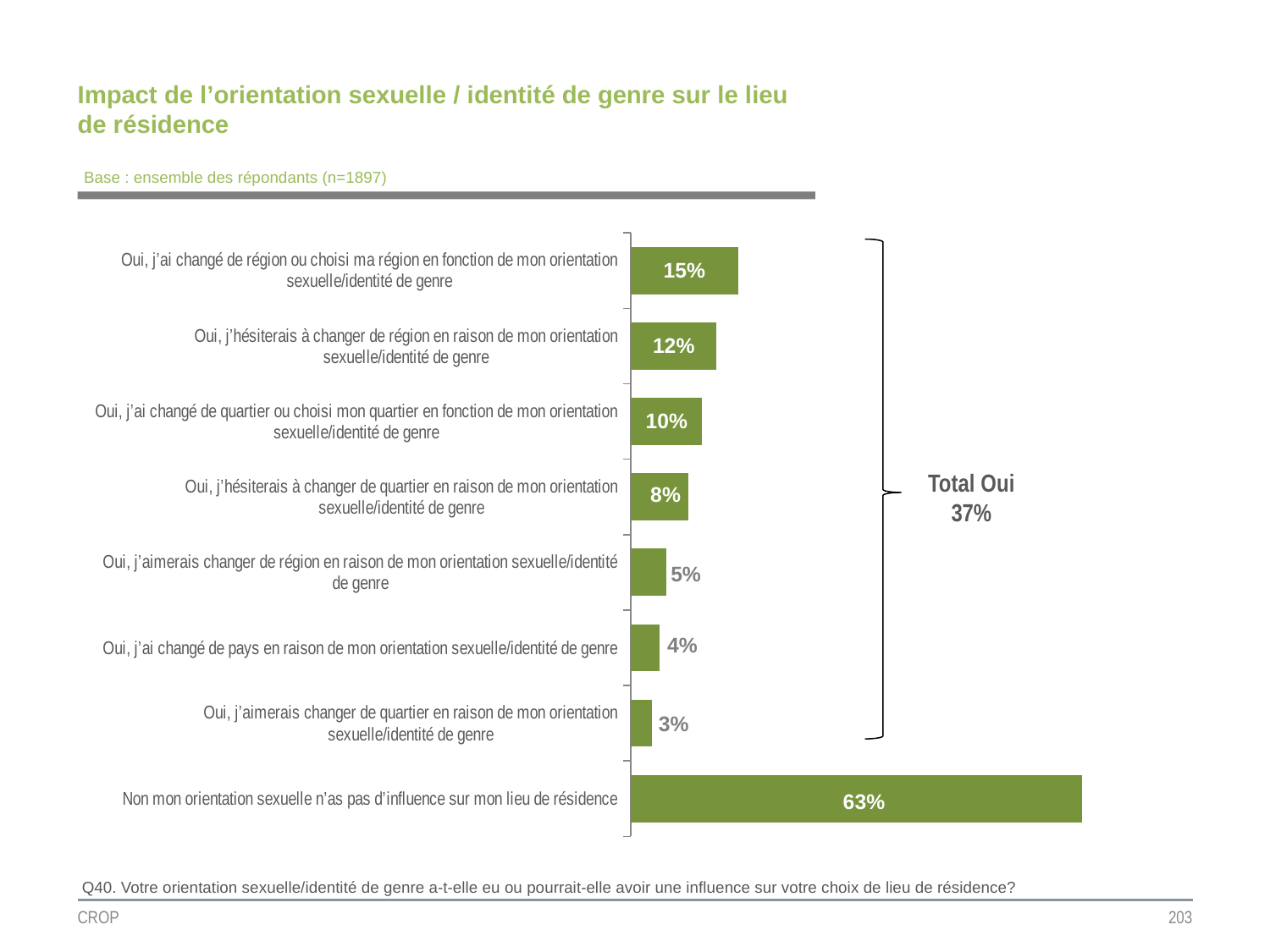
What kind of chart is shown on the slide? Bar chart What is the value for "Oui, j'ai changé de pays en raison de mon orientation sexuelle/identité de genre"? 4% What is the "Total Oui" value shown next to the bracket? 37% What is the difference between the value for "Oui, j'ai changé de région ou choisi ma région..." and the value for "Oui, j'hésiterais à changer de région..."? 3% What is the base (n) stated for the chart? n=1897 What is the value for "Oui, j'ai changé de région ou choisi ma région en fonction de mon orientation sexuelle/identité de genre"? 15% How many categories are shown in the chart? 8 Which category has the highest value? Non mon orientation sexuelle n'as pas d'influence sur mon lieu de résidence Which is larger: the value for "Oui, j'ai changé de quartier ou choisi mon quartier..." or the value for "Oui, j'hésiterais à changer de quartier..."? Oui, j'ai changé de quartier ou choisi mon quartier en fonction de mon orientation sexuelle/identité de genre What is the value for "Non mon orientation sexuelle n'as pas d'influence sur mon lieu de résidence"? 63% What is the value for "Oui, j'aimerais changer de région en raison de mon orientation sexuelle/identité de genre"? 5% Which category has the lowest value? Oui, j'aimerais changer de quartier en raison de mon orientation sexuelle/identité de genre